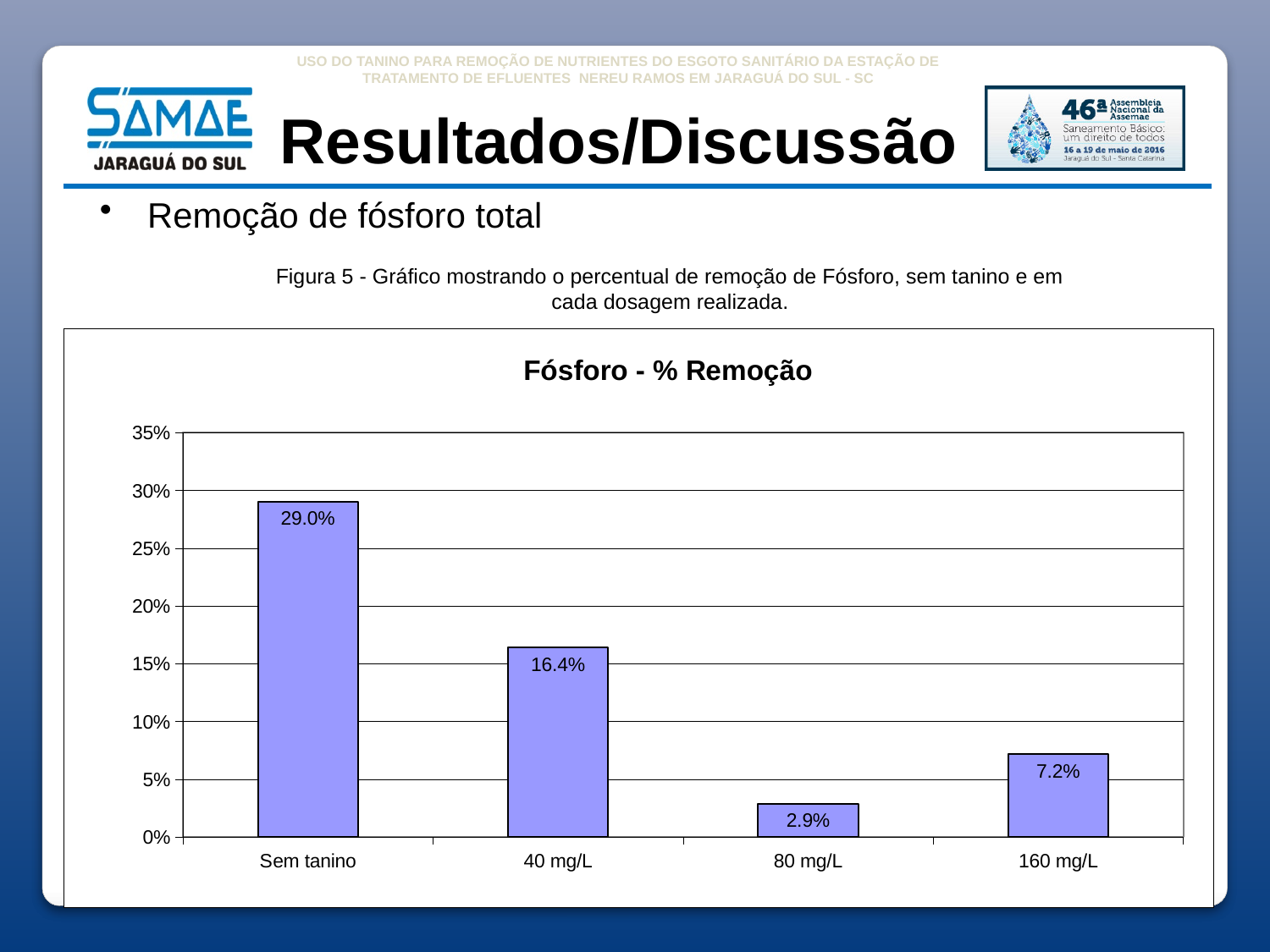
Which category has the highest removal percentage? Sem tanino Which category has the lowest removal percentage? 80 mg/L How many categories are shown on the x axis? 4 Which has a higher removal percentage, 80 mg/L or 160 mg/L? 160 mg/L What is the phosphorus removal percentage at 80 mg/L? 2.9% What is the difference in removal percentage between 'Sem tanino' and 40 mg/L? 12.6% What is the phosphorus removal percentage at 160 mg/L? 7.2% What is the phosphorus removal percentage for 'Sem tanino'? 29.0% What kind of chart is shown? Bar chart Is the value for 40 mg/L greater or less than 15%? greater What is the phosphorus removal percentage at 40 mg/L? 16.4% What is the title of the chart? Fósforo - % Remoção